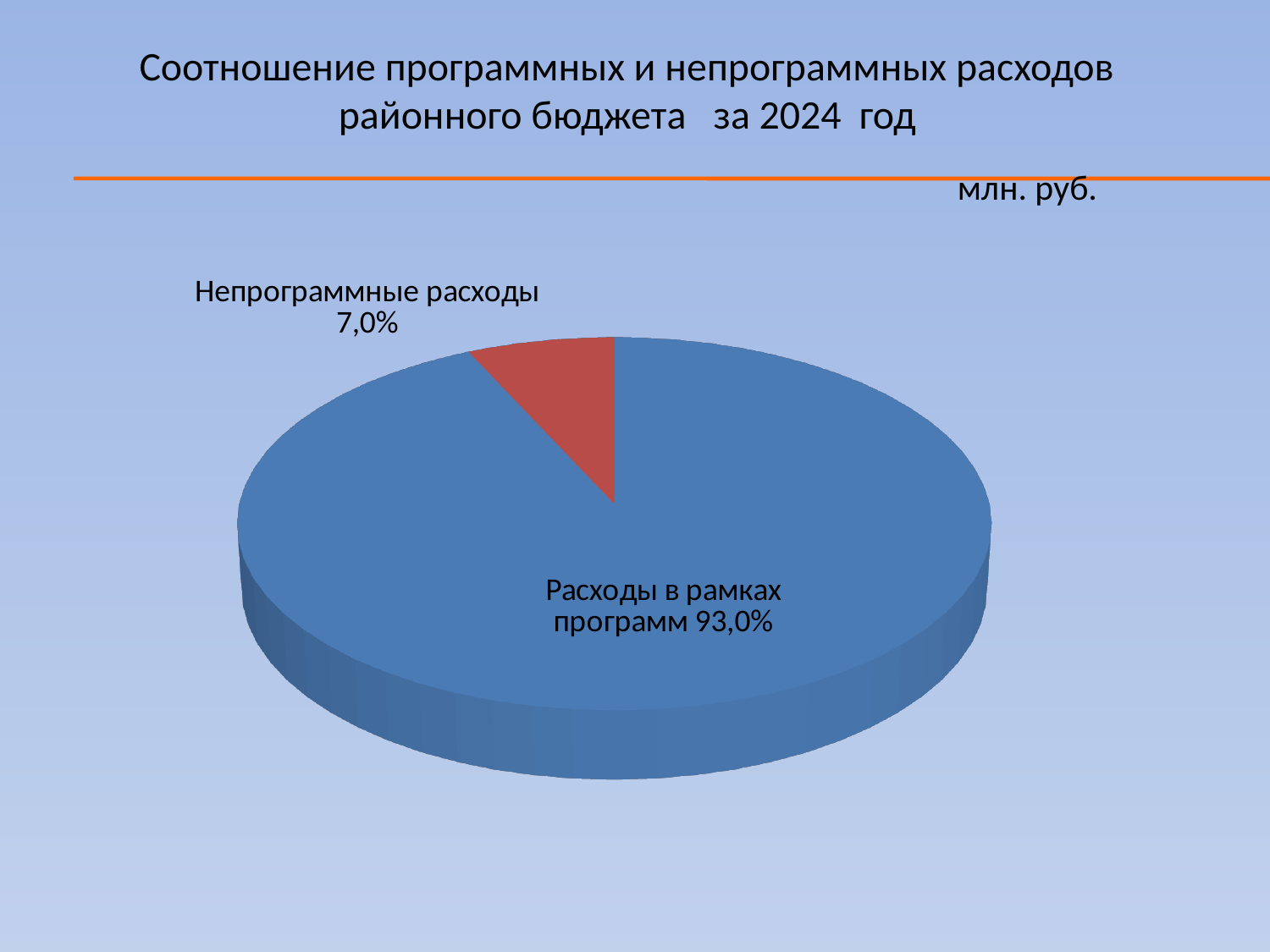
Which slice of the pie is the largest? Расходы в рамках программ Which is larger: the share for 'Непрограммные расходы' or the share for 'Расходы в рамках программ'? Расходы в рамках программ What is the difference in percentage points between 'Расходы в рамках программ' and 'Непрограммные расходы'? 86,0% What colour is the slice for 'Непрограммные расходы'? Red What kind of chart is shown on the slide? Pie chart What share of the pie is labelled for 'Непрограммные расходы'? 7,0% How many slices does the pie chart have? 2 What share of the pie is labelled for 'Расходы в рамках программ'? 93,0% Which slice of the pie is the smallest? Непрограммные расходы What is the title of the chart on the slide? Соотношение программных и непрограммных расходов районного бюджета за 2024 год